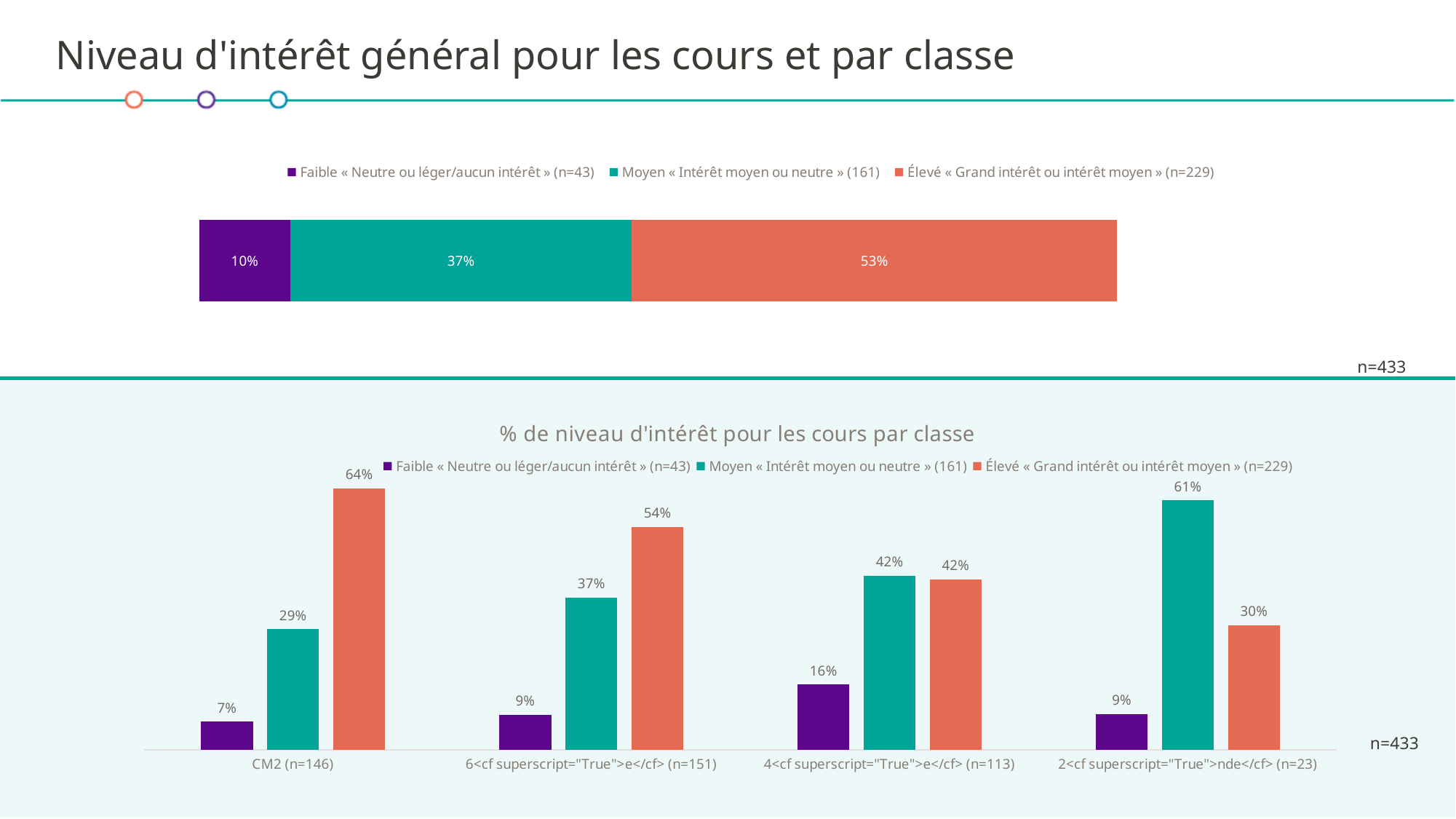
In the chart titled '% de niveau d'intérêt pour les cours par classe', what is the difference between the Élevé and Moyen values for CM2 (n=146)? 35% In the chart titled '% de niveau d'intérêt pour les cours par classe', what is the Élevé value for CM2 (n=146)? 64% How many classes (categories) are shown in the chart titled '% de niveau d'intérêt pour les cours par classe'? 4 In the chart titled '% de niveau d'intérêt pour les cours par classe', is the Moyen value larger for 6e (n=151) or for 2nde (n=23)? 2nde (n=23) In the chart titled '% de niveau d'intérêt pour les cours par classe', which class has the highest Élevé value? CM2 (n=146) In the chart titled '% de niveau d'intérêt pour les cours par classe', what is the Faible value for the third category, 4e (n=113)? 16% In the top stacked bar chart, what is the total of the three segments? 100% How many series does the legend of the chart titled '% de niveau d'intérêt pour les cours par classe' list? 3 In the chart titled '% de niveau d'intérêt pour les cours par classe', which class has the lowest Faible value? CM2 (n=146) In the top stacked bar chart, what percentage is shown for the Faible « Neutre ou léger/aucun intérêt » segment? 10% In the chart titled '% de niveau d'intérêt pour les cours par classe', what is the Moyen value for the last category on the right, 2nde (n=23)? 61% In the top stacked bar chart, what percentage is shown for the Élevé « Grand intérêt ou intérêt moyen » segment? 53%